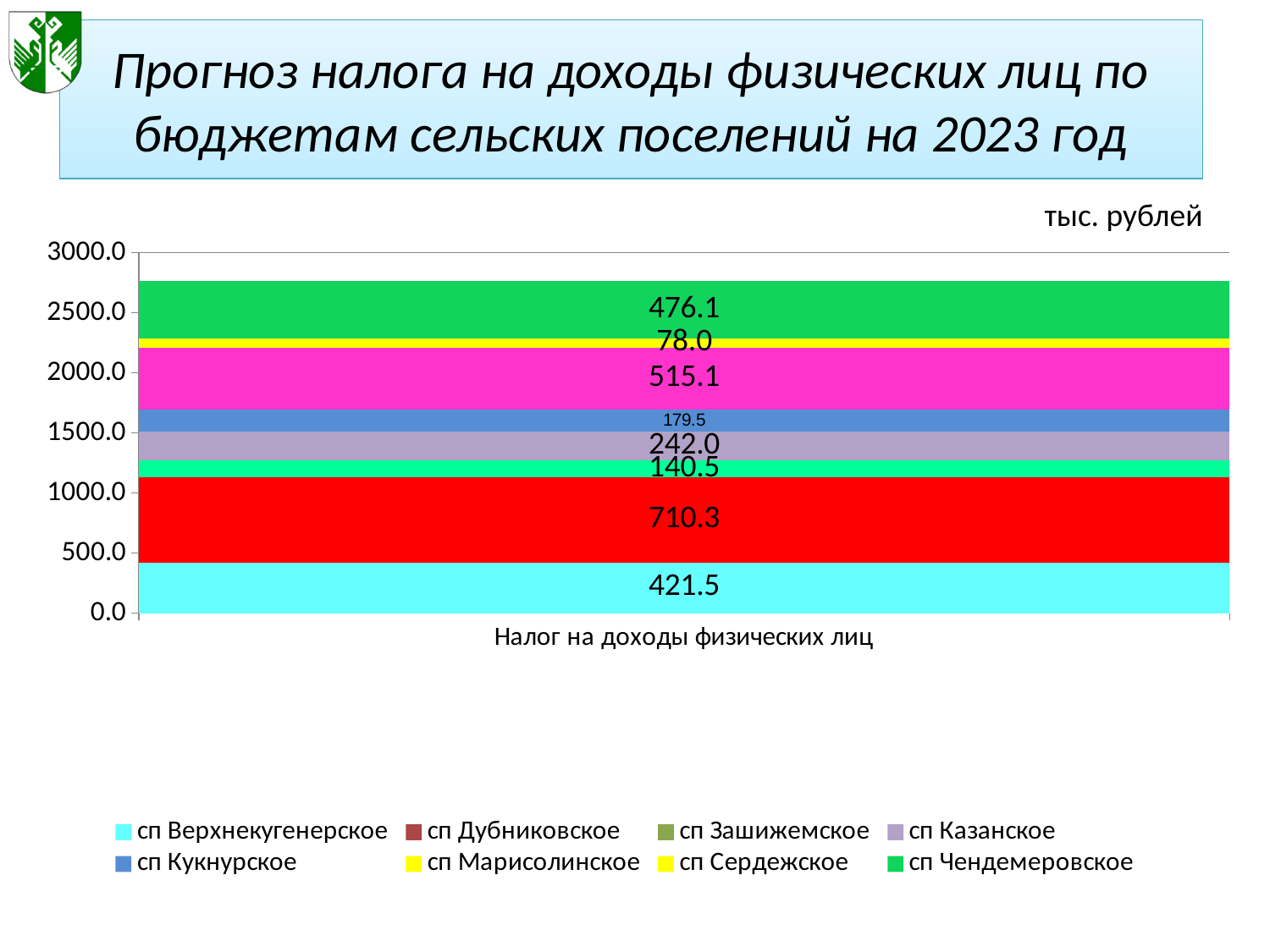
How many series does the legend list? 8 What is the value for сп Верхнекугенерское? 421.5 What is the value for сп Чендемеровское? 476.1 How many categories are plotted on the x axis? 1 What is the value for сп Кукнурское? 179.5 What is the difference between the values for сп Чендемеровское and сп Казанское? 234.1 What is the largest segment value in the stacked bar? 710.3 What is the value for сп Казанское? 242.0 What is the smallest segment value in the stacked bar? 78.0 What kind of chart is shown on the slide? stacked bar chart What is the total of the stacked bar for Налог на доходы физических лиц? 2763.0 What is the value for сп Сердежское? 78.0